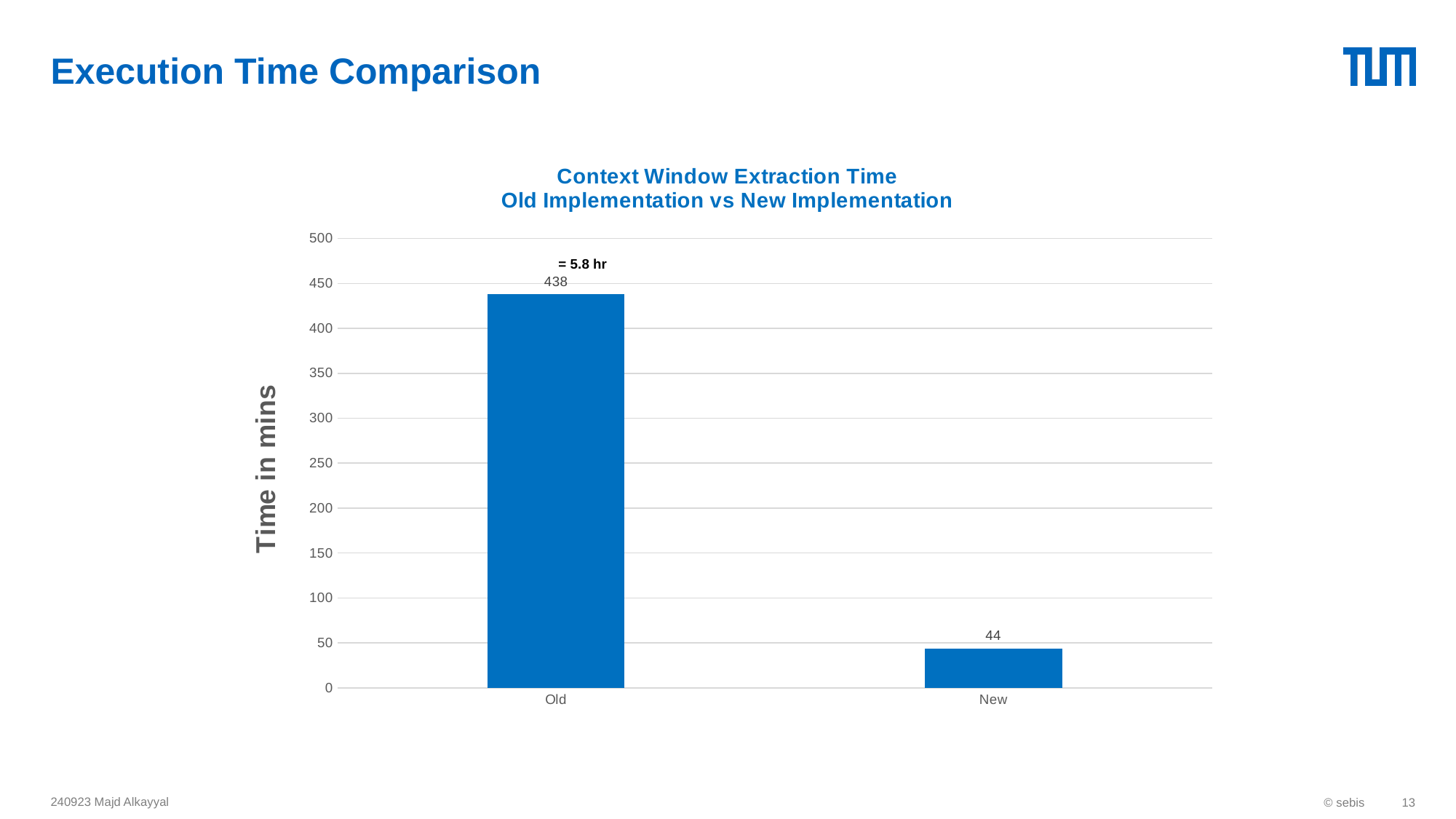
What is the title of the chart? Context Window Extraction Time Old Implementation vs New Implementation What is the value for New? 44 Which category has the lowest value? New Which is larger, the value for Old or the value for New? Old How many categories are shown on the x axis? 2 What is the value for Old? 438 Which category has the highest value? Old Is the value for Old greater or less than 400? greater What kind of chart is shown? bar chart Is the value for New greater or less than 50? less What is the difference between the values for Old and New? 394 What is the label of the y axis? Time in mins